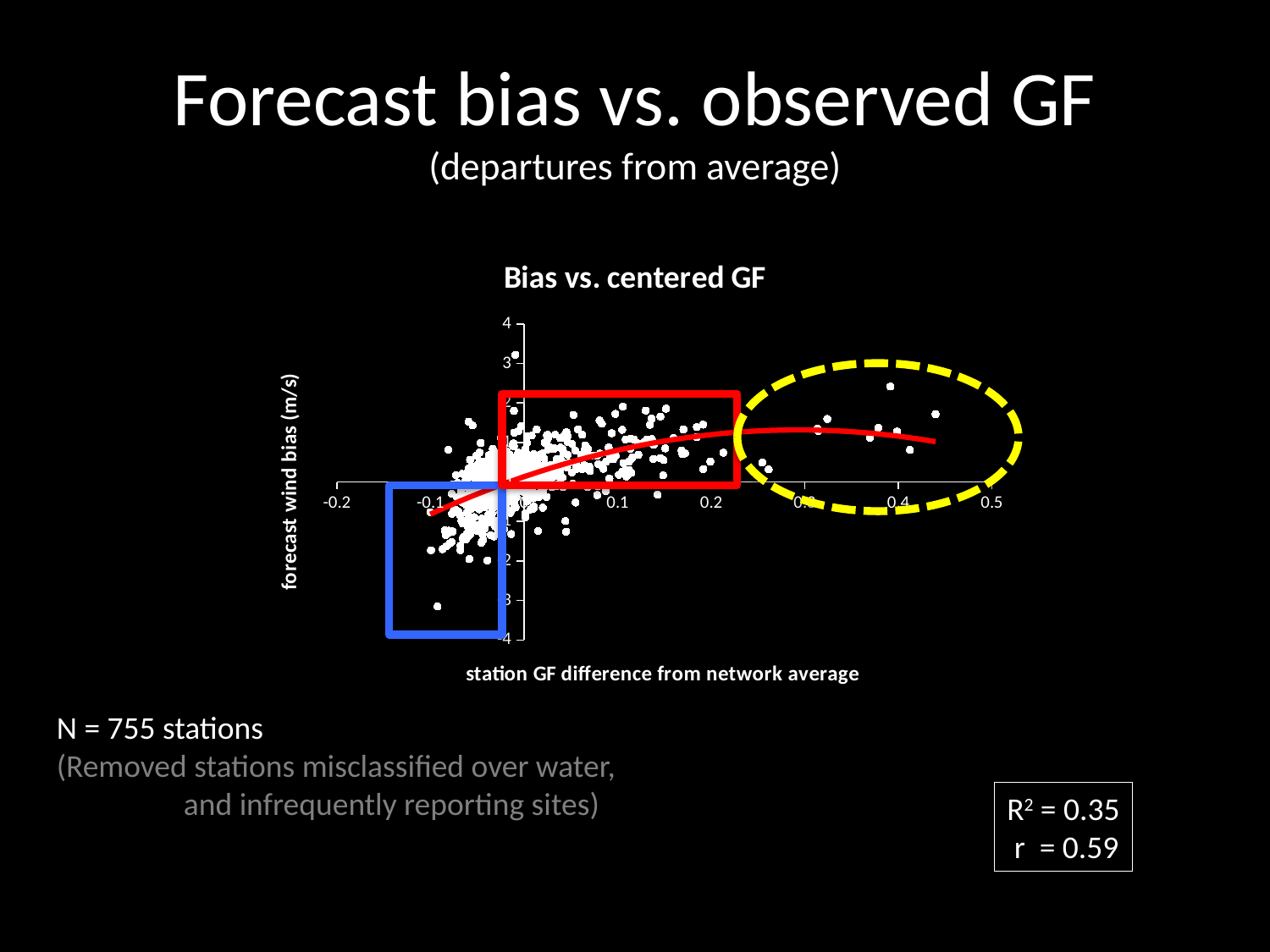
What is the smallest value shown on the x axis? -0.2 What is the largest value shown on the y axis? 4 What is the title of the chart? Bias vs. centered GF Is the forecast wind bias of the highest point on the chart greater or less than 2? greater What is the label of the y axis? forecast wind bias (m/s) What correlation coefficient r is reported for the relationship shown in the chart? 0.59 Overall, does forecast wind bias rise or fall as station GF difference from network average increases? rise What kind of chart is shown on the slide? scatter chart How many stations are plotted in the chart, according to the slide? 755 What R² value is reported for the relationship shown in the chart? 0.35